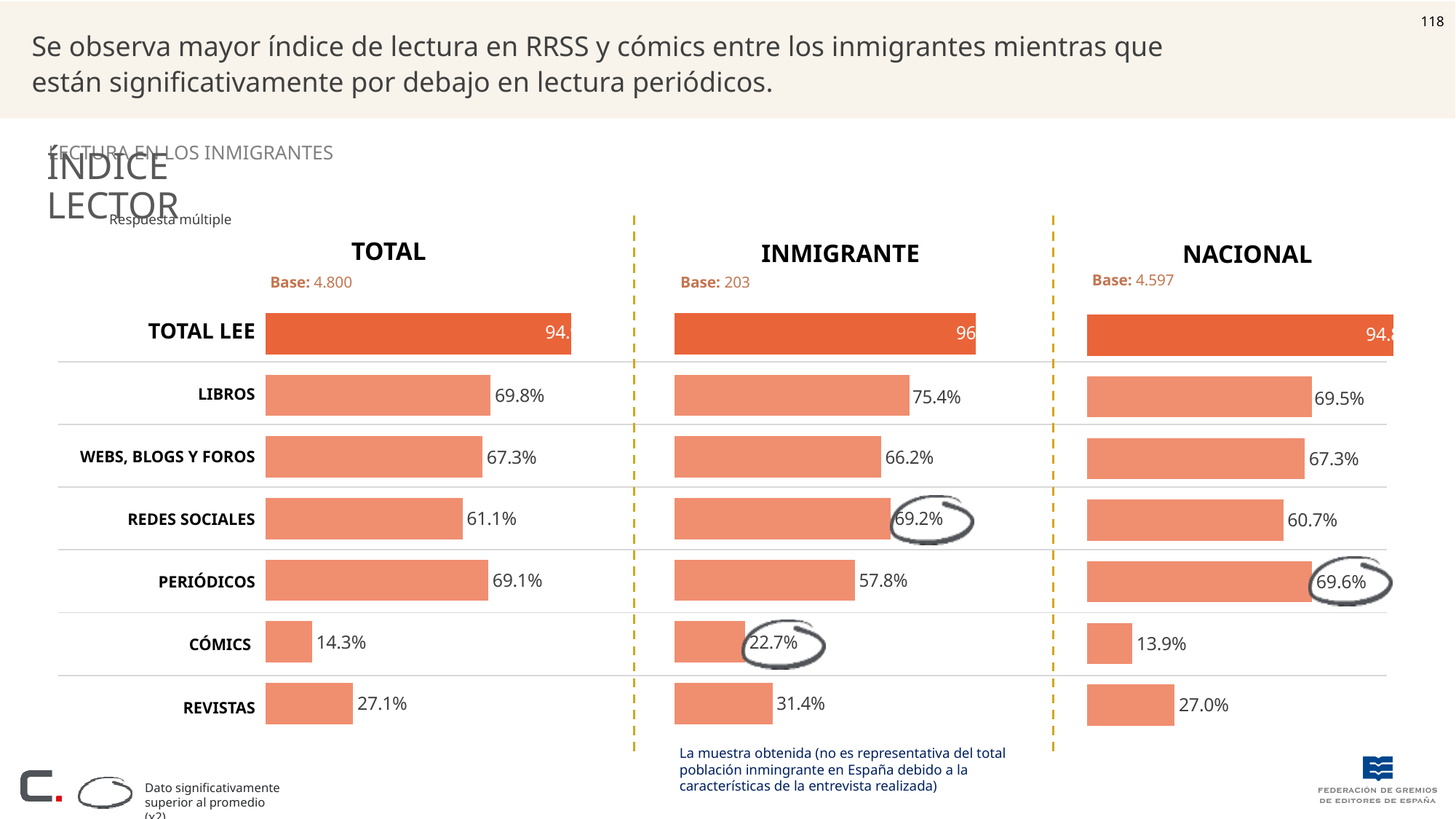
In the INMIGRANTE chart, excluding TOTAL LEE, which category has the lowest value? CÓMICS In the TOTAL chart, what is the value for CÓMICS? 14.3% In the INMIGRANTE chart, what is the value for REDES SOCIALES? 69.2% What is the base (sample size) shown for the INMIGRANTE chart? 203 In the NACIONAL chart, excluding TOTAL LEE, which category has the highest value? PERIÓDICOS Which is larger: the CÓMICS value in the INMIGRANTE chart or the CÓMICS value in the NACIONAL chart? INMIGRANTE What is the difference between the PERIÓDICOS value in the TOTAL chart and the PERIÓDICOS value in the INMIGRANTE chart? 11.3% In the NACIONAL chart, what is the value for PERIÓDICOS? 69.6% What kind of chart is used in the INMIGRANTE section? Bar chart What is the difference between the REVISTAS value in the INMIGRANTE chart and the REVISTAS value in the NACIONAL chart? 4.4% In the INMIGRANTE chart, what is the value for LIBROS? 75.4% How many categories are shown in the TOTAL chart, including TOTAL LEE? 7